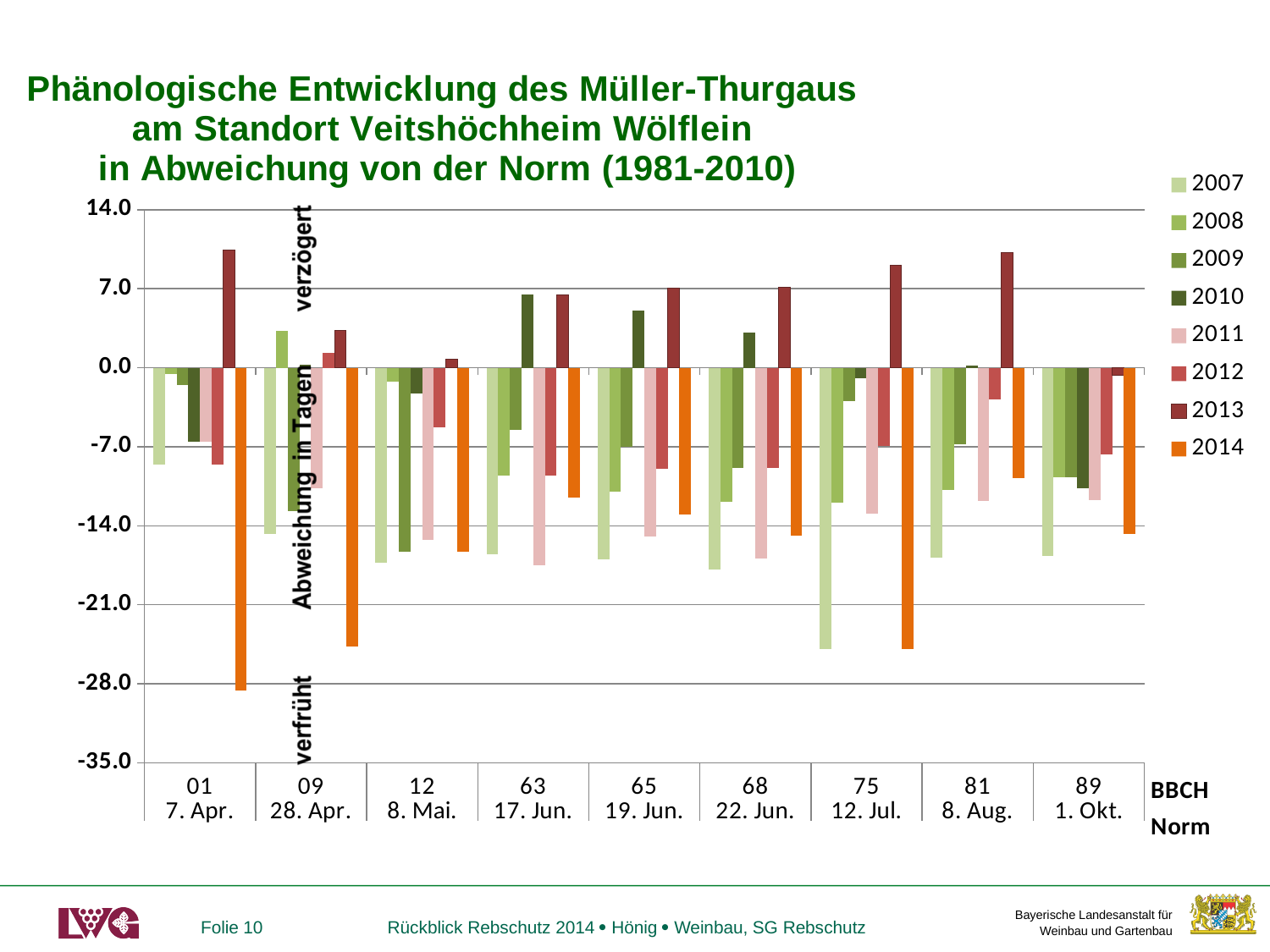
Which year has the highest value at BBCH 81 (8. Aug.)? 2013 Is the value for 2007 at BBCH 12 (8. Mai.) greater or less than -14.0? less How many BBCH stages are shown along the x axis? 9 Is the value for 2014 at BBCH 09 (28. Apr.) greater or less than -21.0? less How many years (series) does the legend list? 8 Which year has the lowest value at BBCH 01 (7. Apr.)? 2014 What kind of chart is shown on the slide? bar chart Is the value for 2014 at BBCH 01 (7. Apr.) greater or less than -21.0? less What is the label on the vertical axis of the chart? Abweichung in Tagen At BBCH 09 (28. Apr.), which is larger: the value for 2008 or the value for 2014? 2008